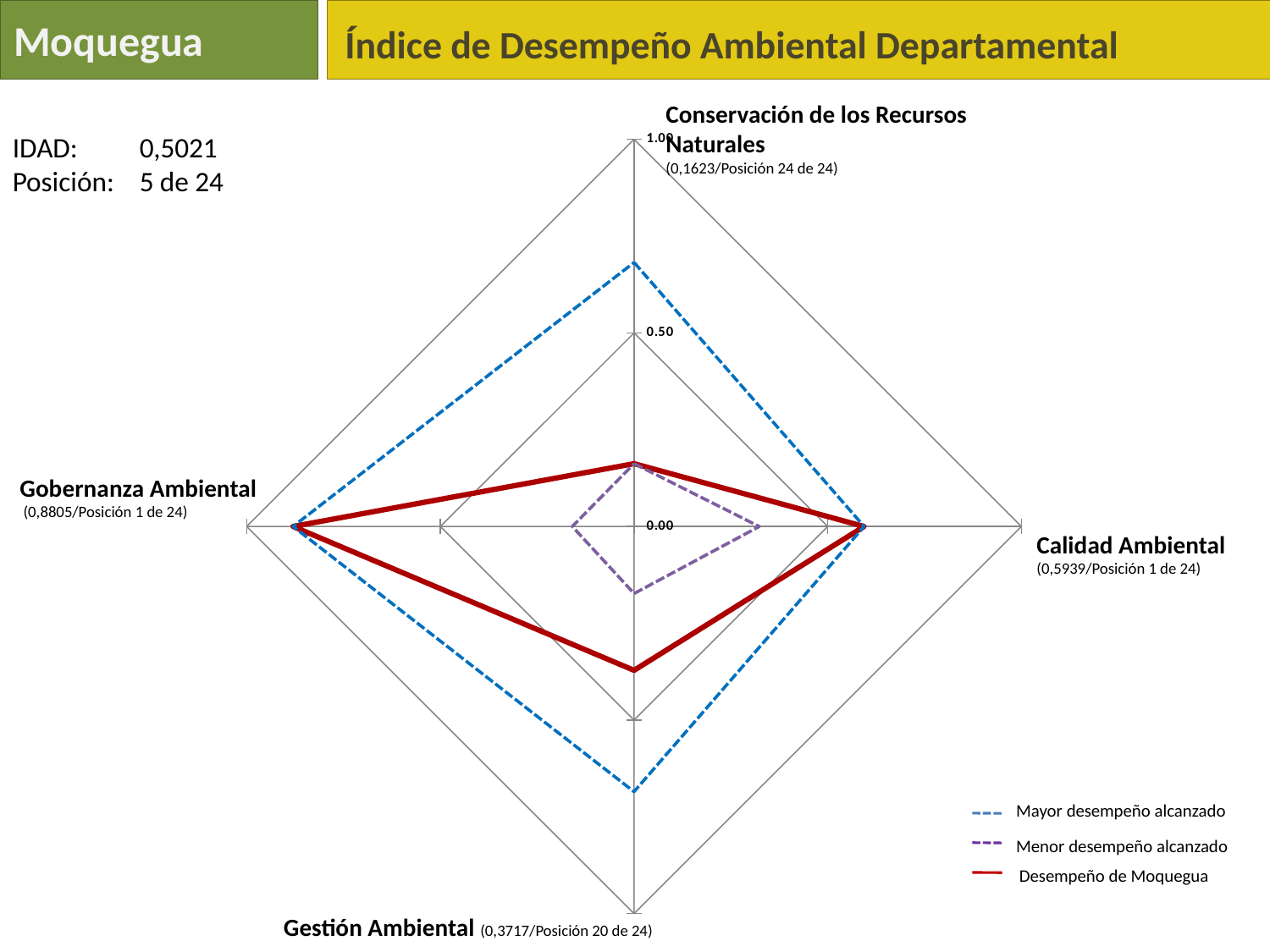
How many series does the legend list? 3 What is Moquegua's value for Gestión Ambiental? 0,3717 In which category does Moquegua have its highest value? Gobernanza Ambiental What is the difference between Moquegua's values for Calidad Ambiental and Gestión Ambiental? 0,2222 In which category does Moquegua have its lowest value? Conservación de los Recursos Naturales Which is larger for Moquegua: Calidad Ambiental or Gestión Ambiental? Calidad Ambiental How many categories (axes) does the radar chart have? 4 Is the value of the 'Mayor desempeño alcanzado' series for Gobernanza Ambiental greater or less than 0.50? greater What kind of chart is shown on the slide? radar chart Which series is drawn with the solid red line? Desempeño de Moquegua What is Moquegua's value for Conservación de los Recursos Naturales? 0,1623 What is Moquegua's value for Gobernanza Ambiental? 0,8805